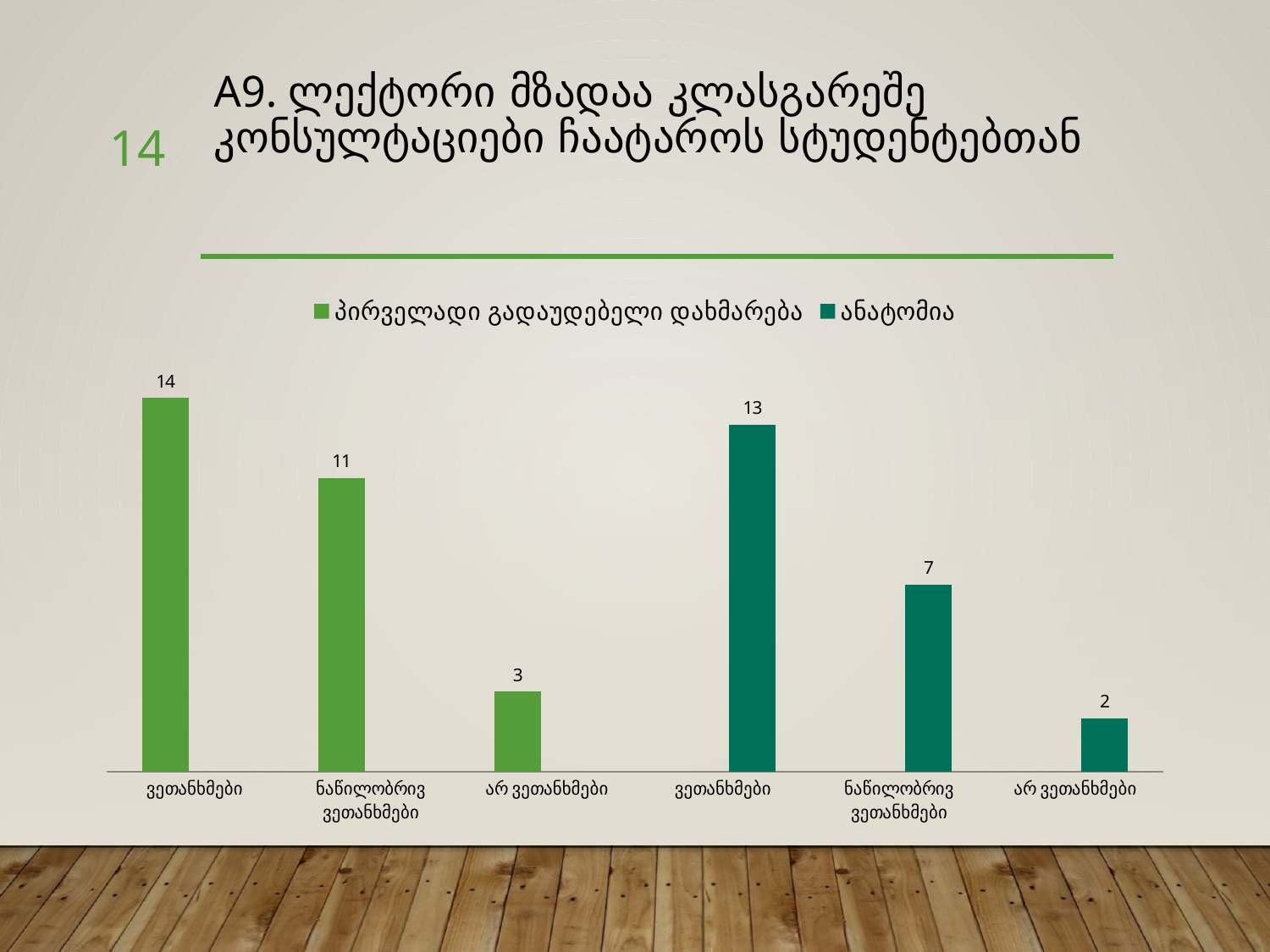
Which is larger: "ნაწილობრივ ვეთანხმები" in the "პირველადი გადაუდებელი დახმარება" series or "ნაწილობრივ ვეთანხმები" in the "ანატომია" series? პირველადი გადაუდებელი დახმარება What is the difference between "ნაწილობრივ ვეთანხმები" and "არ ვეთანხმები" in the "ანატომია" series? 5 What kind of chart is shown on the slide? Bar chart What is the difference between the "ვეთანხმები" values of the "პირველადი გადაუდებელი დახმარება" and "ანატომია" series? 1 Which category has the highest value in the "ანატომია" series? ვეთანხმები What is the value for "ვეთანხმები" in the "ანატომია" series? 13 What is the value for "ნაწილობრივ ვეთანხმები" in the "ანატომია" series? 7 Which category has the lowest value in the "პირველადი გადაუდებელი დახმარება" series? არ ვეთანხმები Do the values in the "ანატომია" series rise or fall from "ვეთანხმები" to "არ ვეთანხმები"? Fall How many series does the legend list? 2 What is the value for "ვეთანხმები" in the "პირველადი გადაუდებელი დახმარება" series? 14 What is the value for "არ ვეთანხმები" in the "პირველადი გადაუდებელი დახმარება" series? 3